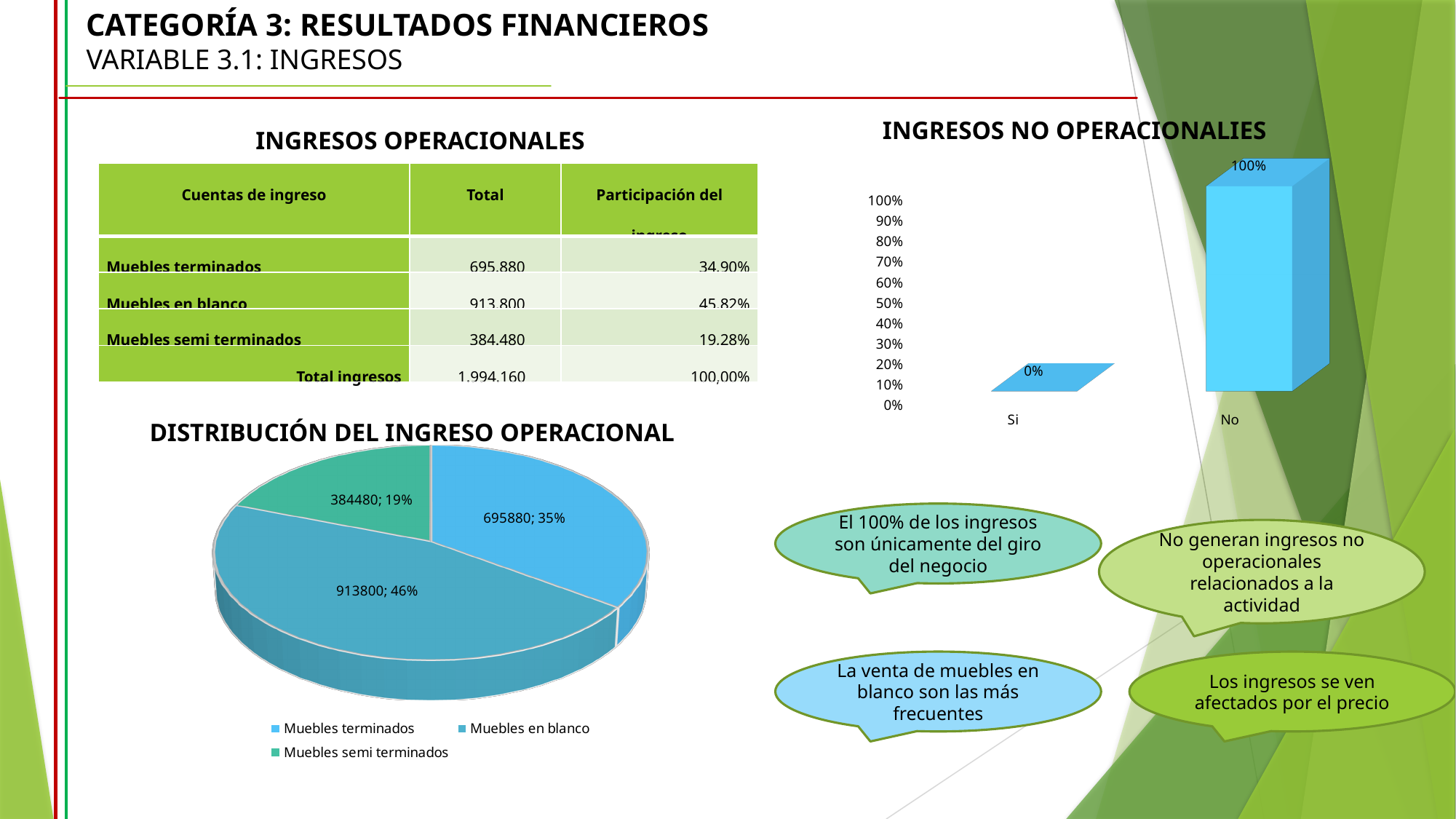
In the pie chart 'DISTRIBUCIÓN DEL INGRESO OPERACIONAL', which category has the smallest slice? Muebles semi terminados In the bar chart on the right ('INGRESOS NO OPERACIONALES'), what value is shown for Si? 0% What kind of chart is 'DISTRIBUCIÓN DEL INGRESO OPERACIONAL'? Pie chart What kind of chart is the chart on the right titled 'INGRESOS NO OPERACIONALES'? Bar chart In the pie chart 'DISTRIBUCIÓN DEL INGRESO OPERACIONAL', what is the difference between the values for Muebles en blanco and Muebles terminados? 217920 In the bar chart on the right ('INGRESOS NO OPERACIONALES'), what value is shown for No? 100% In the pie chart 'DISTRIBUCIÓN DEL INGRESO OPERACIONAL', what percentage share does Muebles semi terminados have? 19% In the pie chart 'DISTRIBUCIÓN DEL INGRESO OPERACIONAL', what percentage share does Muebles terminados have? 35% In the pie chart 'DISTRIBUCIÓN DEL INGRESO OPERACIONAL', what value is shown for Muebles en blanco? 913800; 46% In the pie chart 'DISTRIBUCIÓN DEL INGRESO OPERACIONAL', how many categories does the legend list? 3 In the pie chart 'DISTRIBUCIÓN DEL INGRESO OPERACIONAL', which category has the largest slice? Muebles en blanco In the bar chart on the right ('INGRESOS NO OPERACIONALES'), which category is larger, Si or No? No